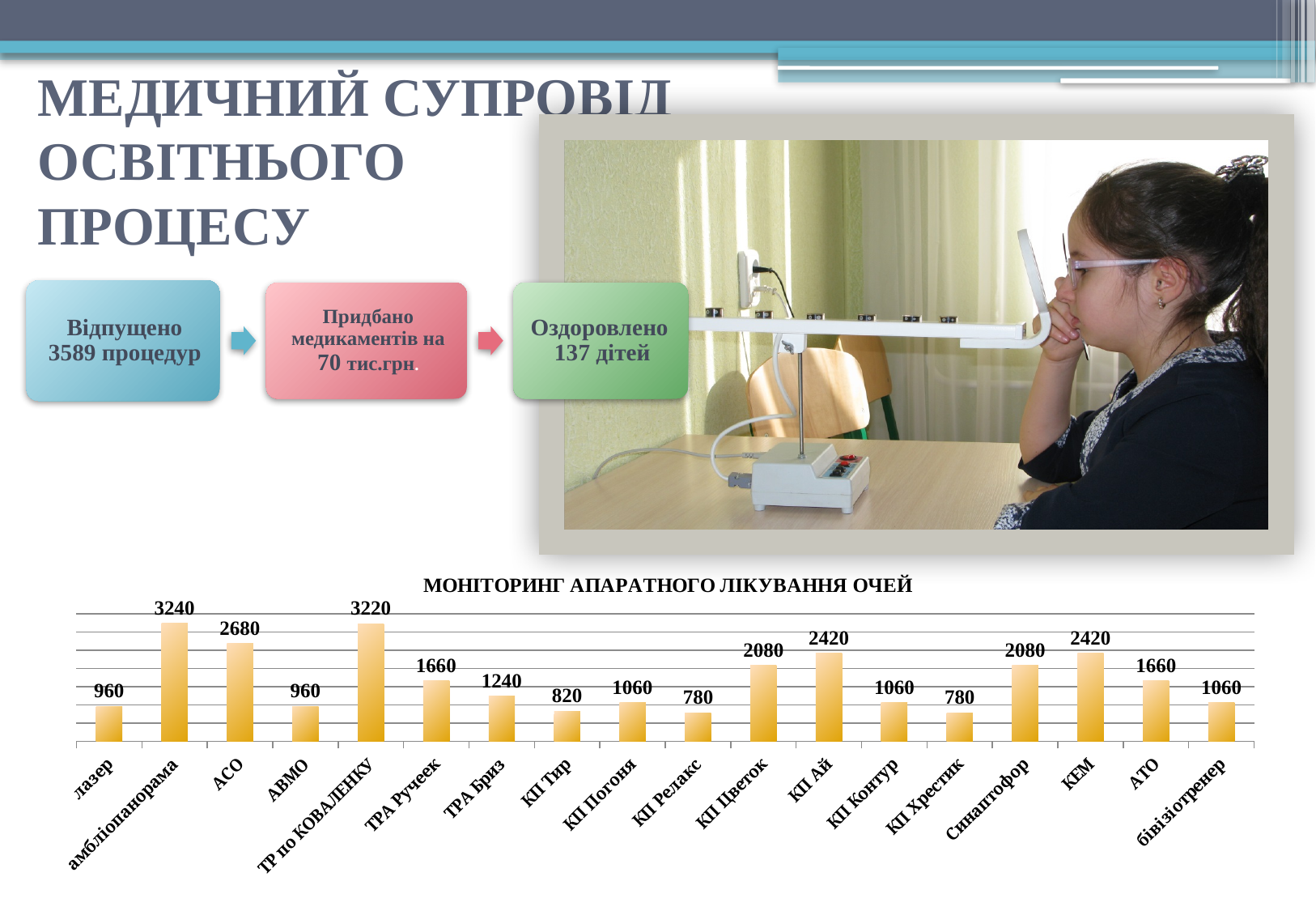
Which category has the highest value in the chart? амбліопанорама What is the title of the chart on the slide? МОНІТОРИНГ АПАРАТНОГО ЛІКУВАННЯ ОЧЕЙ Which is larger, the value for КЕМ or the value for АТО? КЕМ What is the difference between the values for КП Ай and КП Контур? 1360 What is the value for бівізіотренер? 1060 Which is larger, the value for ТРА Ручеек or the value for ТРА Бриз? ТРА Ручеек What is the value for ТР по КОВАЛЕНКУ? 3220 What is the value for амбліопанорама? 3240 What type of chart is shown on the slide? bar chart What is the value for КП Цветок? 2080 What is the difference between the values for АСО and АВМО? 1720 How many categories are plotted in the chart? 18